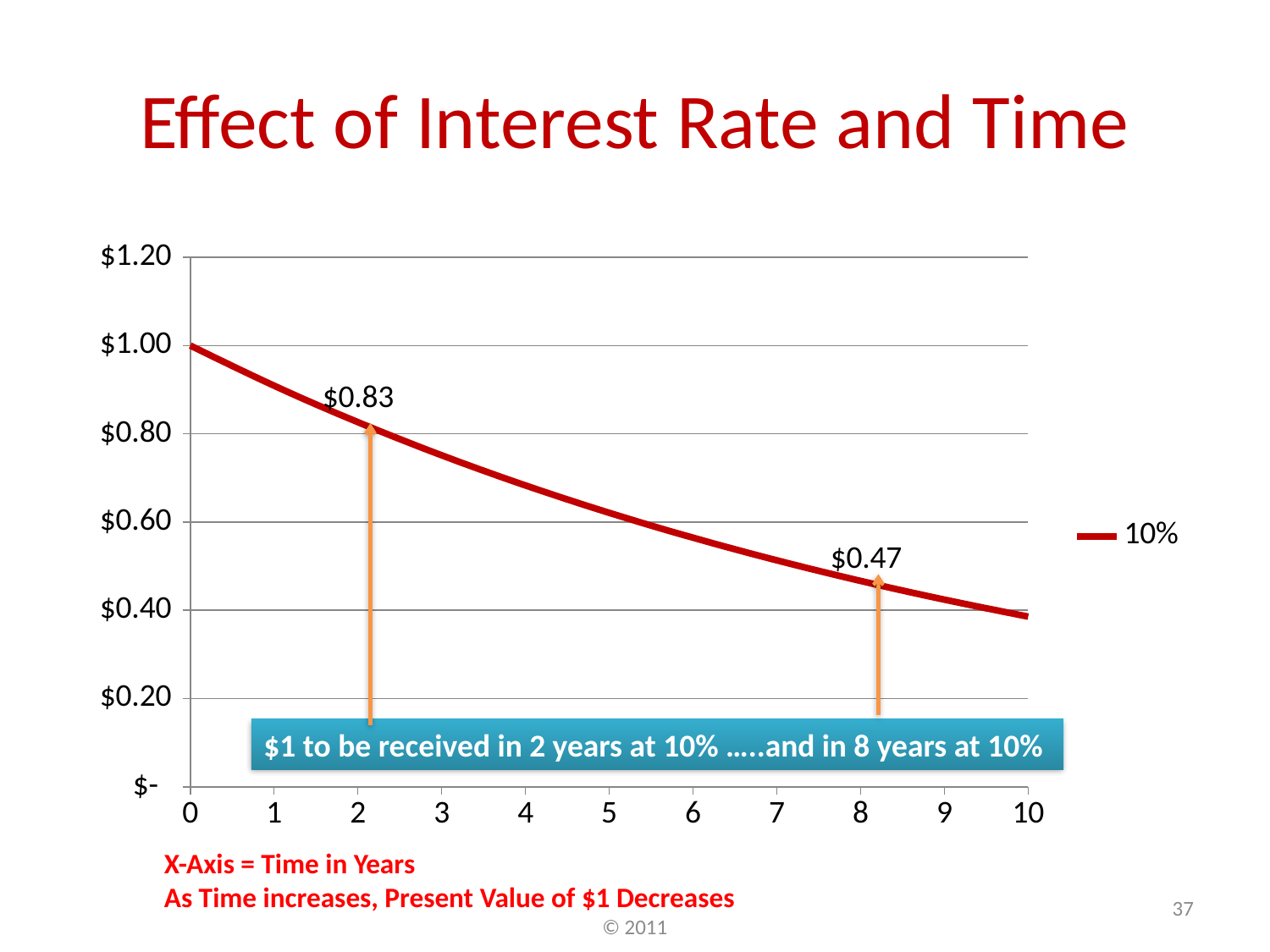
What is the present value shown for $1 to be received in 2 years at 10%? $0.83 Is the value of the 10% line at year 4 greater or less than $0.60? greater Which is larger, the present value at 2 years or at 8 years? 2 years What kind of chart is shown on the slide? line chart What is the title of the slide containing the chart? Effect of Interest Rate and Time How many series does the legend list? 1 What is the difference between the labelled values at 2 years and at 8 years? $0.36 What is the value of the 10% line at year 0? $1.00 What is the present value shown for $1 to be received in 8 years at 10%? $0.47 Does the 10% line rise or fall as time in years increases? fall Is the value of the 10% line at year 6 greater or less than $0.60? less Is the value of the 10% line at year 1 greater or less than $1.00? less